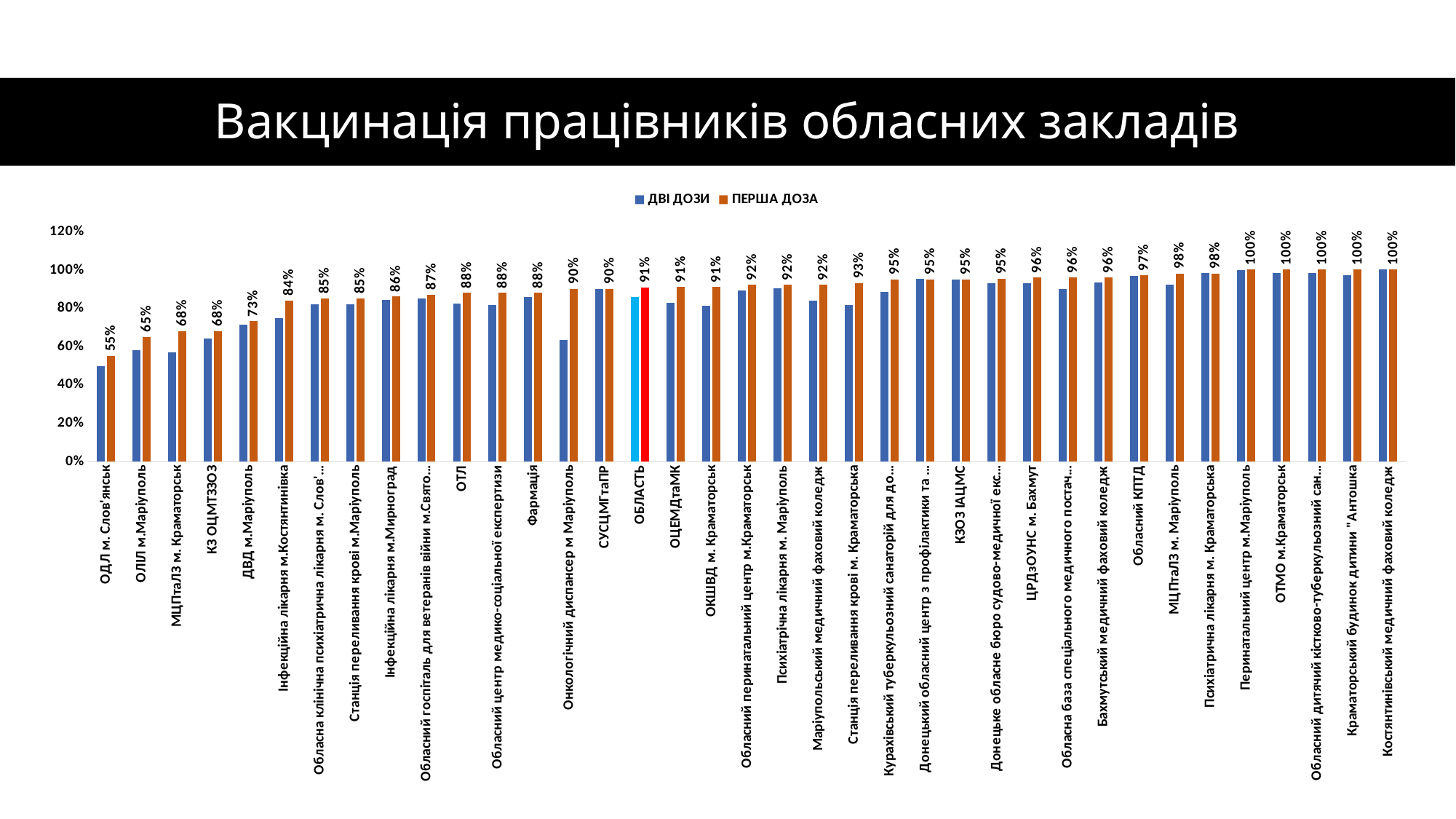
What is the ПЕРША ДОЗА value for ОДЛ м. Слов'янськ? 55% What is the title of the chart? Вакцинація працівників обласних закладів Do the ПЕРША ДОЗА values generally rise or fall from left to right along the x axis? rise What kind of chart is shown on the slide? bar chart Which category has the lowest ПЕРША ДОЗА value? ОДЛ м. Слов'янськ Is the ДВІ ДОЗИ value for ОДЛ м. Слов'янськ greater or less than 60%? less What are the two series named in the legend? ДВІ ДОЗИ and ПЕРША ДОЗА How many series does the legend list? 2 What is the ПЕРША ДОЗА value for Обласний КПТД? 97% Which has a higher ПЕРША ДОЗА value, ОТЛ or Станція переливання крові м. Краматорська? Станція переливання крові м. Краматорська What is the difference between the ПЕРША ДОЗА values for ДВД м.Маріуполь and ОЛІЛ м.Маріуполь? 8% What is the ПЕРША ДОЗА value for ОБЛАСТЬ? 91%